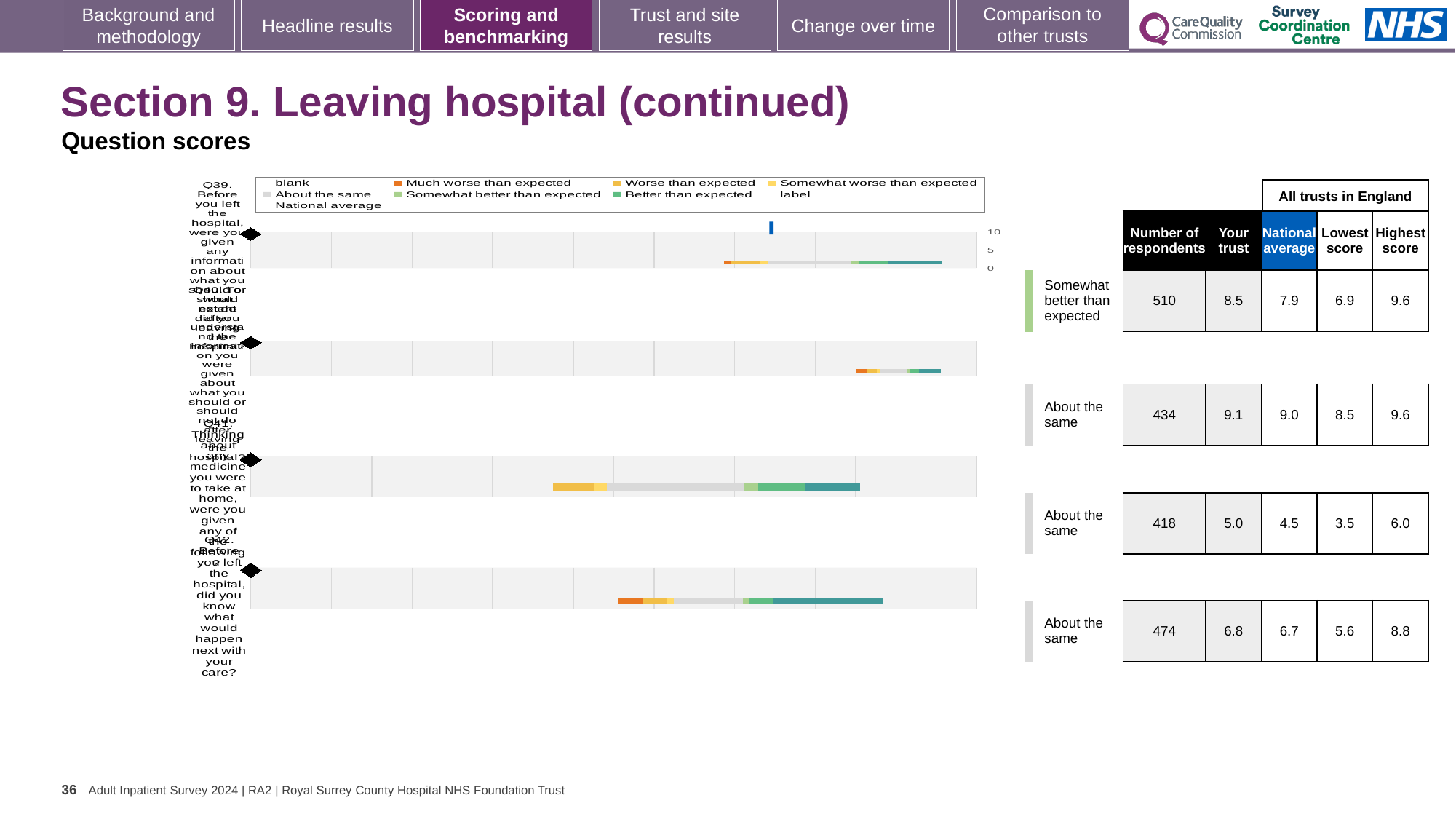
What is the difference between the 'Your trust' score and the national average for Q39 (the first row)? 0.6 How many question bars are plotted in the chart? 4 In the table beside the chart, what is the national average for Q42 (the last row)? 6.7 Which row of the table has the highest 'Your trust' score? the second row (9.1) Which row of the table has the lowest 'Your trust' score? the third row (5.0) What kind of chart is shown on the slide? bar chart Is the 'Your trust' score for Q42 (the last row) larger or smaller than its national average? larger In the table beside the chart, what is the 'Your trust' score for Q39 (the first row)? 8.5 What benchmark category is shown for Q39 (the first row)? Somewhat better than expected In the table beside the chart, how many respondents are listed for Q39 (the first row)? 510 What is the difference between the highest and lowest scores for the third row of the table? 2.5 In the table beside the chart, what is the highest score for Q42 (the last row)? 8.8